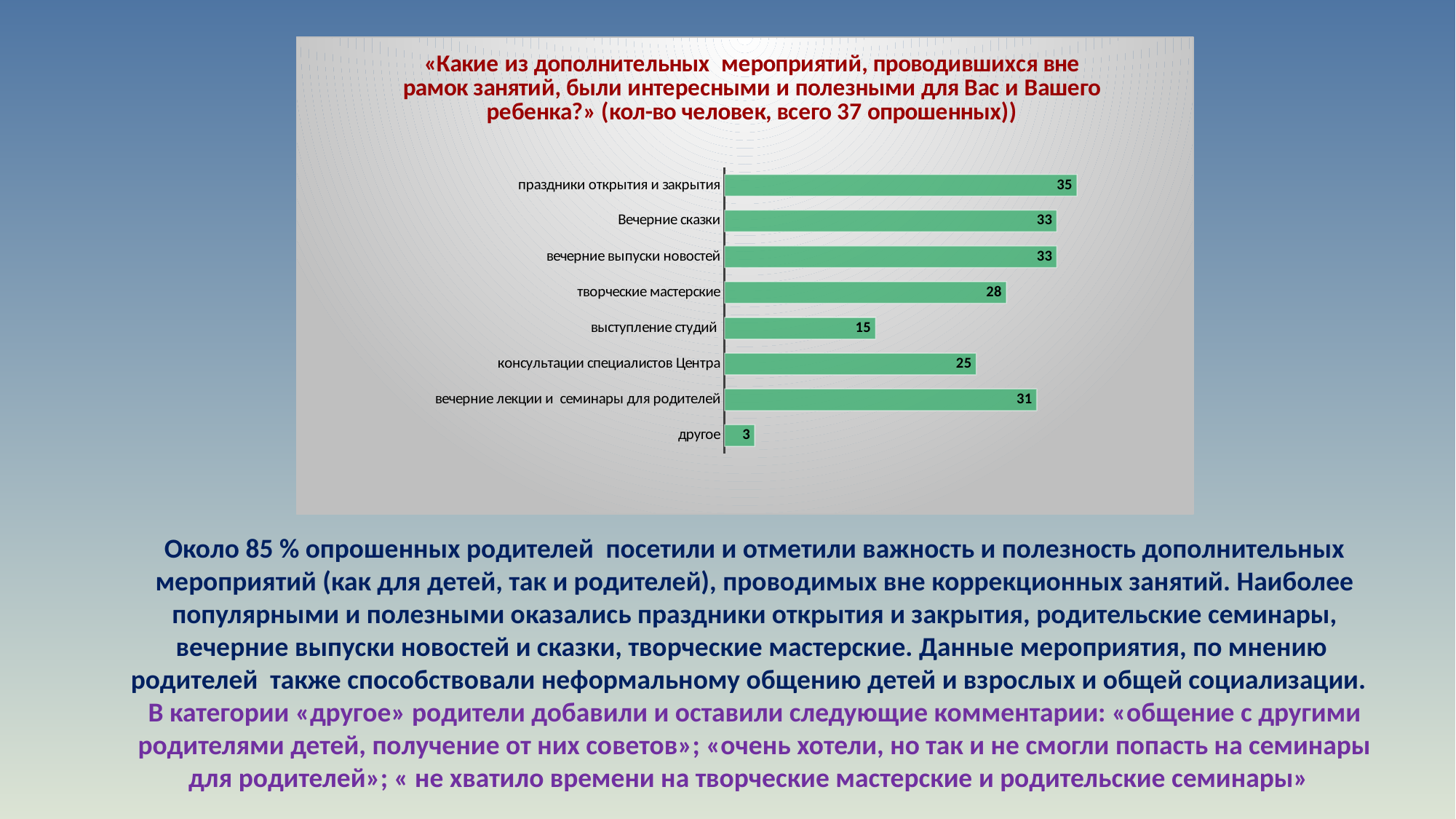
What value is shown for «выступление студий»? 15 Which category has the lowest value? другое How many categories are shown in the chart? 8 What value is shown for «консультации специалистов Центра»? 25 Which category has the highest value? праздники открытия и закрытия What value is shown for «творческие мастерские»? 28 According to the chart title, how many people were surveyed in total? 37 Which is larger: the value for «творческие мастерские» or the value for «консультации специалистов Центра»? творческие мастерские What is the difference between the values for «праздники открытия и закрытия» and «выступление студий»? 20 What is the difference between the values for «вечерние лекции и семинары для родителей» and «консультации специалистов Центра»? 6 What type of chart is shown on the slide? bar chart What value is shown for «праздники открытия и закрытия»? 35